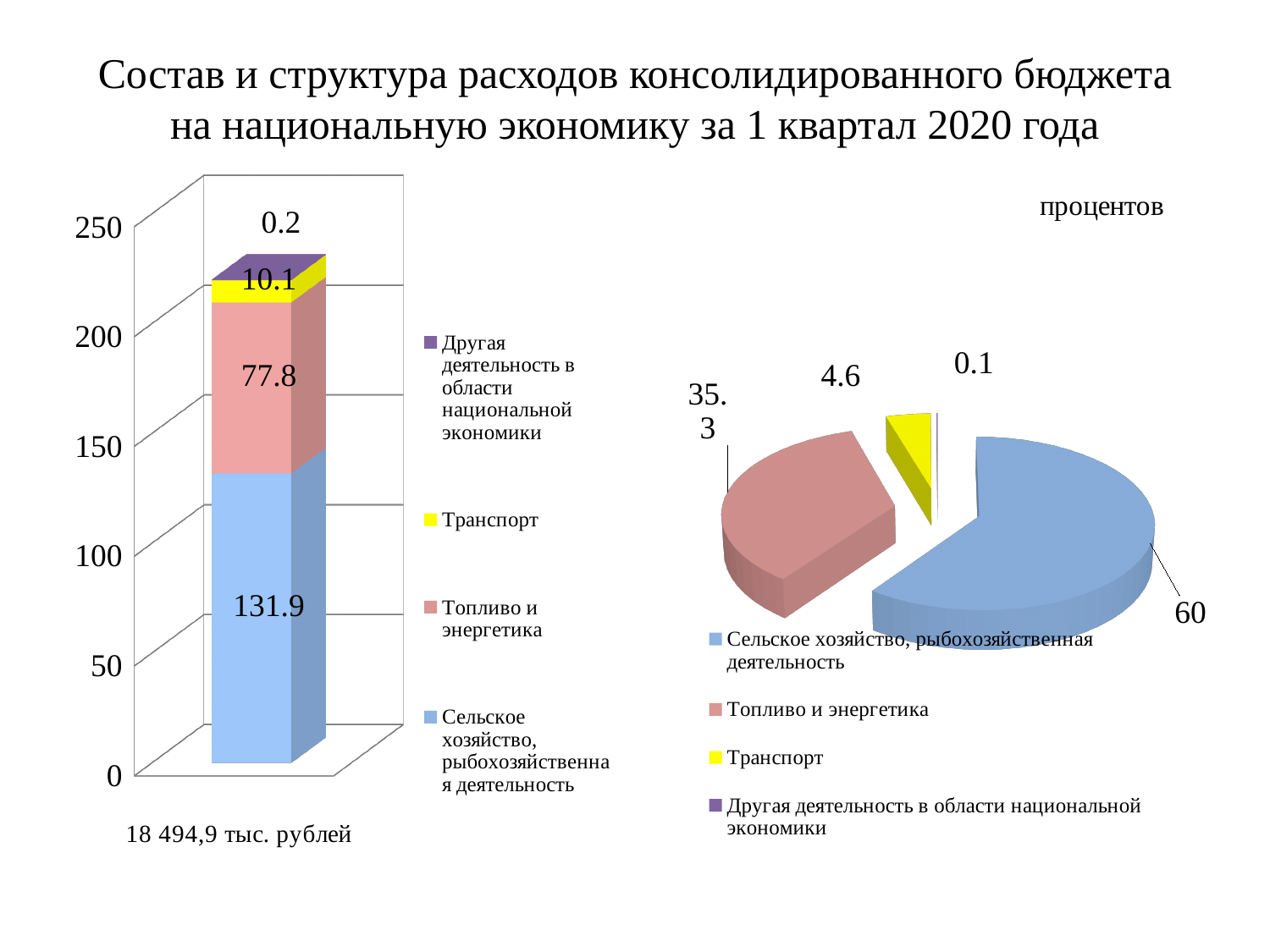
In the bar chart on the left, what is the total of the stacked bar? 220.0 In the pie chart on the right, what is the value for Транспорт? 4.6 What type of chart is on the right side of the slide? pie chart In the pie chart on the right, which category has the smallest slice? Другая деятельность в области национальной экономики In the bar chart on the left, what is the difference between Сельское хозяйство, рыбохозяйственная деятельность and Топливо и энергетика? 54.1 In the bar chart on the left, what is the value for Сельское хозяйство, рыбохозяйственная деятельность? 131.9 In the pie chart on the right, what share does Сельское хозяйство, рыбохозяйственная деятельность have? 60 In the bar chart on the left, what is the value for Другая деятельность в области национальной экономики? 0.2 In the bar chart on the left, what is the value for Транспорт? 10.1 What type of chart is on the left side of the slide? bar chart In the bar chart on the left, what is the value for Топливо и энергетика? 77.8 How many entries does the legend of the pie chart on the right list? 4